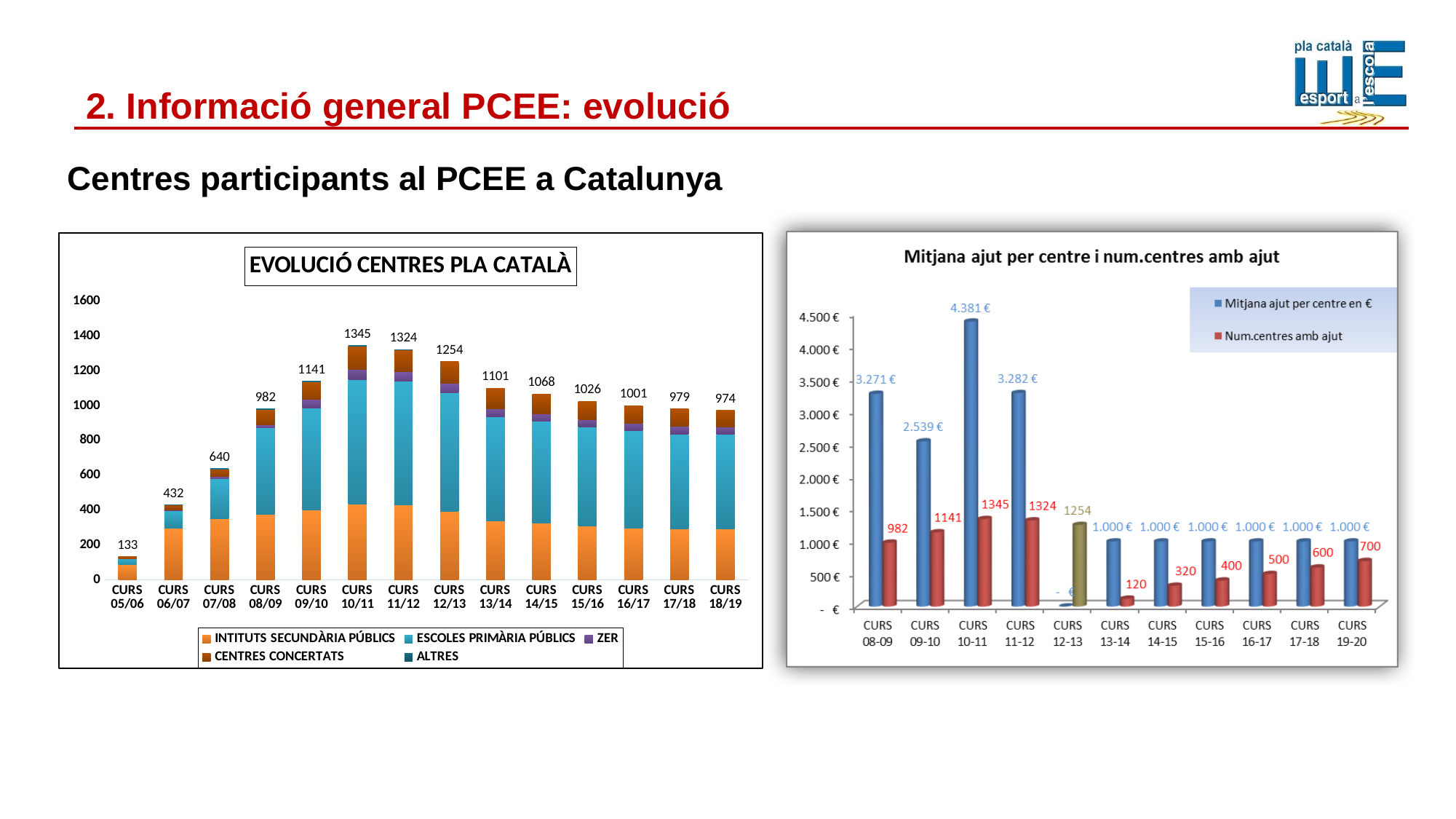
In the chart titled EVOLUCIÓ CENTRES PLA CATALÀ, which school year has the lowest total? CURS 05/06 In the chart titled Mitjana ajut per centre i num.centres amb ajut, how many series does the legend list? 2 In the chart titled EVOLUCIÓ CENTRES PLA CATALÀ, how many series does the legend list? 5 In the chart titled Mitjana ajut per centre i num.centres amb ajut, does the Num.centres amb ajut rise or fall from CURS 13-14 to CURS 19-20? rise In the chart titled EVOLUCIÓ CENTRES PLA CATALÀ, is the total for CURS 08/09 greater or less than 1000? less In the chart titled EVOLUCIÓ CENTRES PLA CATALÀ, what is the total number of centres for CURS 10/11? 1345 In the chart titled Mitjana ajut per centre i num.centres amb ajut, which school year has the highest Mitjana ajut per centre? CURS 10-11 In the chart titled Mitjana ajut per centre i num.centres amb ajut, what is the Num.centres amb ajut for CURS 14-15? 320 In the chart titled EVOLUCIÓ CENTRES PLA CATALÀ, how many school years are shown on the x axis? 14 In the chart titled EVOLUCIÓ CENTRES PLA CATALÀ, what is the difference between the totals for CURS 10/11 and CURS 18/19? 371 In the chart titled Mitjana ajut per centre i num.centres amb ajut, what is the Mitjana ajut per centre for CURS 10-11? 4.381 € In the chart titled EVOLUCIÓ CENTRES PLA CATALÀ, which school year has the highest total? CURS 10/11